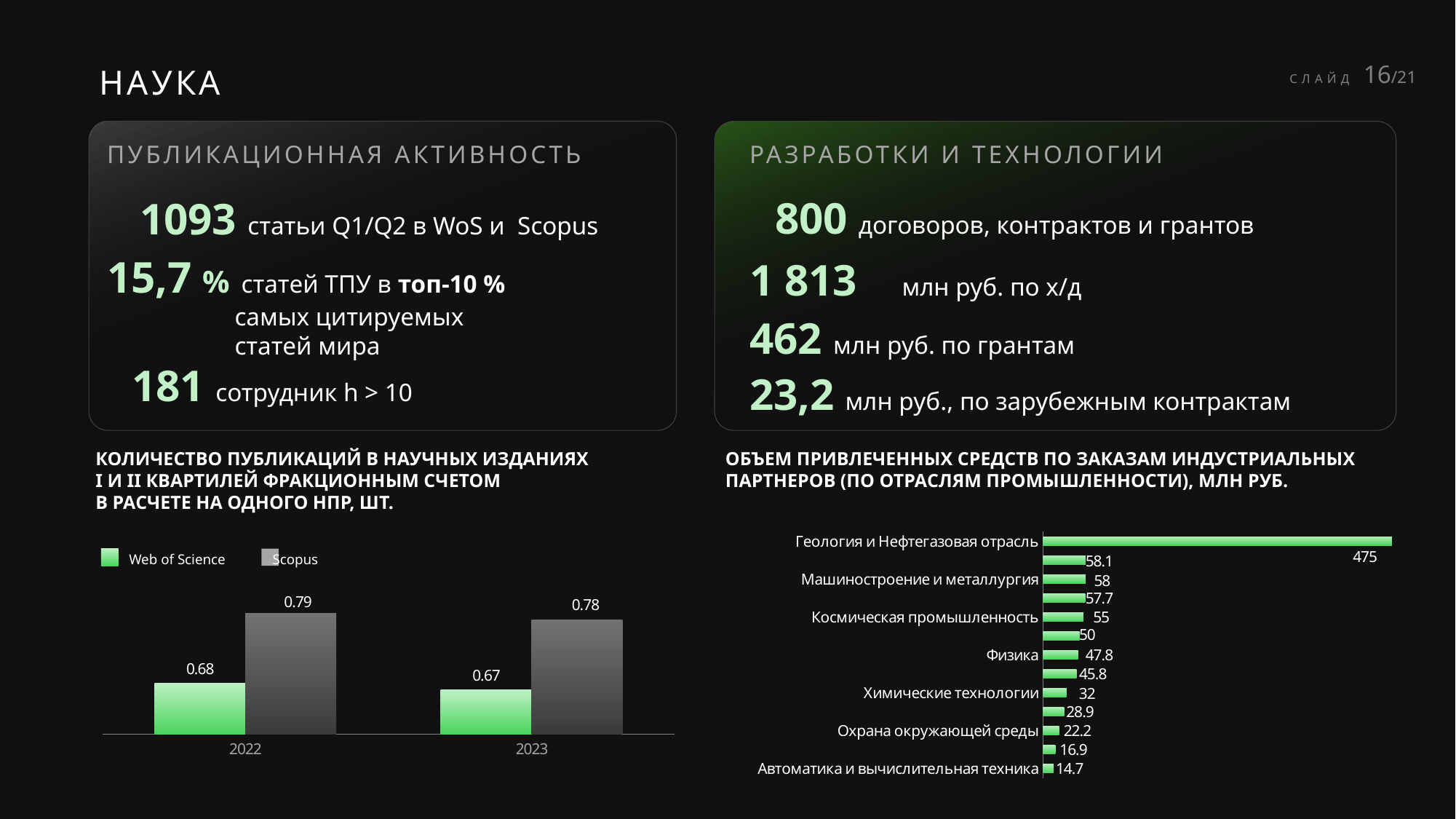
In the left chart (publications per NPR), how many series does the legend list? 2 In the right chart (funds attracted by industry), which category has the lowest value? Автоматика и вычислительная техника In the right chart (funds attracted by industry), what is the value for Геология и Нефтегазовая отрасль? 475 In the left chart (publications per NPR), what is the Scopus value for 2023? 0.78 In the right chart (funds attracted by industry), which category has the highest value? Геология и Нефтегазовая отрасль In the left chart (publications per NPR), what is the difference between the Scopus and Web of Science values in 2022? 0.11 In the left chart (publications per NPR), does the Web of Science value rise or fall from 2022 to 2023? fall In the right chart (funds attracted by industry), what is the difference between Химические технологии and Охрана окружающей среды? 9.8 In the left chart (publications per NPR), which series has the larger value in 2023, Web of Science or Scopus? Scopus In the right chart (funds attracted by industry), what is the value for Физика? 47.8 What kind of chart is the left chart (publications per NPR)? bar chart In the left chart (publications per NPR), what is the Web of Science value for 2022? 0.68